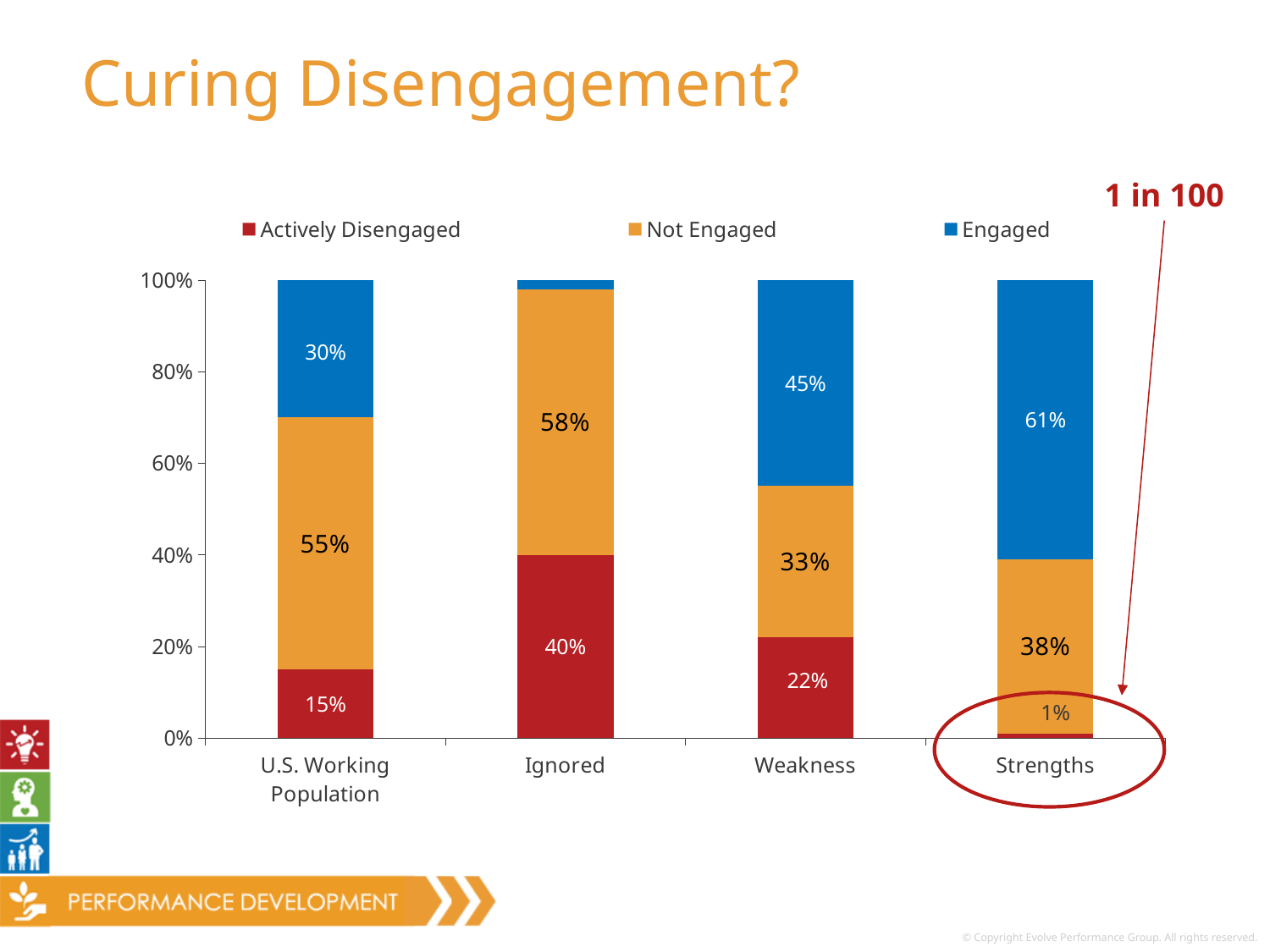
Which category has the lowest Actively Disengaged value? Strengths Is the Engaged value for the Ignored category greater or less than 20%? less How many categories are shown on the x axis? 4 What is the Not Engaged value for the Weakness category? 33% What is the Actively Disengaged value for the Ignored category? 40% Which category has the highest Engaged value? Strengths How many series does the legend list? 3 What is the difference between the Engaged values for Strengths and Weakness? 16% What is the Actively Disengaged value for the U.S. Working Population? 15% What kind of chart is shown on the slide? Stacked bar chart Which has the larger Not Engaged value, Ignored or U.S. Working Population? Ignored What is the Engaged value for the Strengths category? 61%